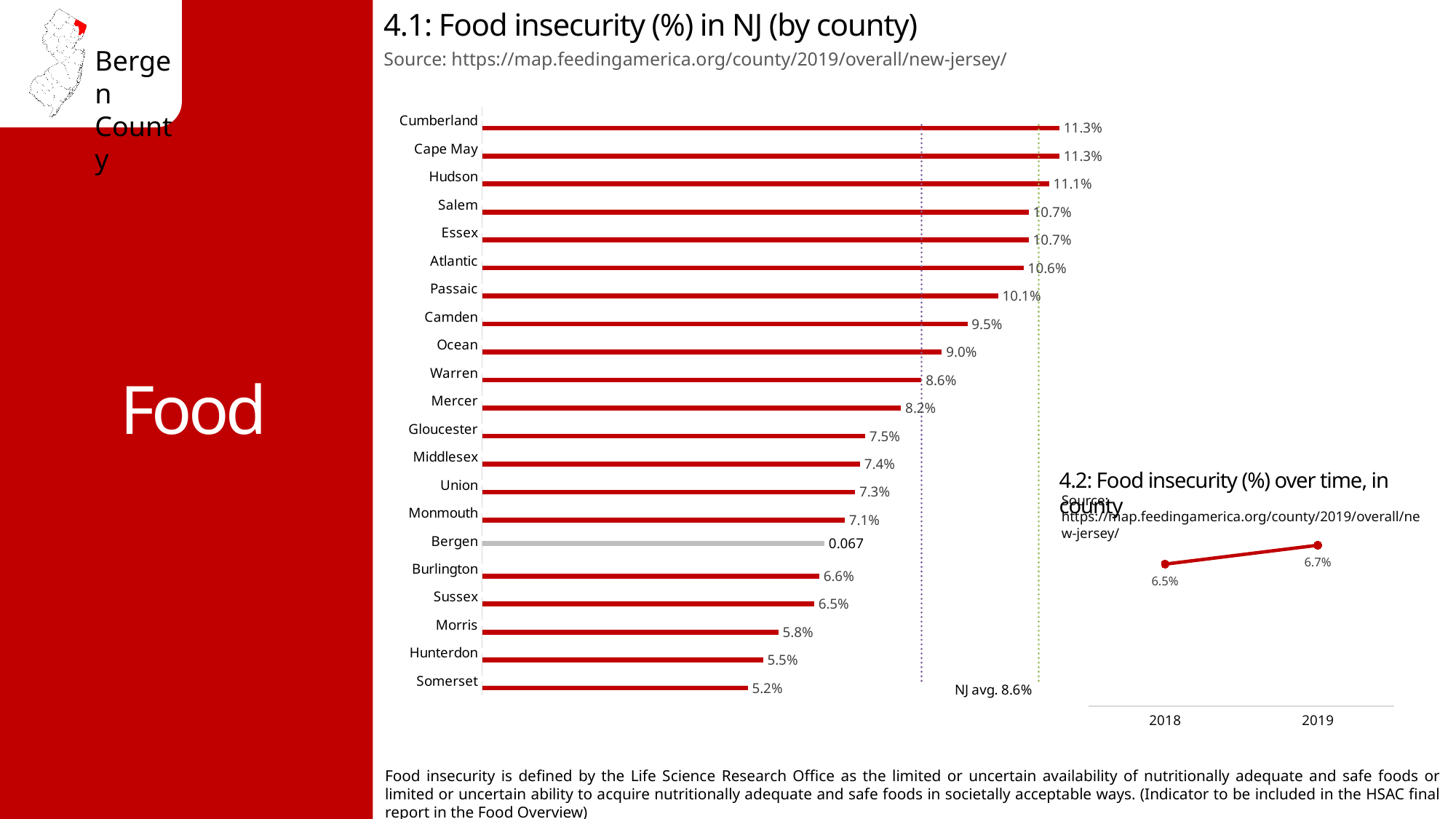
In chart 4.2 (Food insecurity (%) over time, in county), what is the value for 2019? 6.7% In chart 4.2 (Food insecurity (%) over time, in county), what is the difference between the 2019 and 2018 values? 0.2 percentage points In chart 4.1 (Food insecurity (%) in NJ by county), what is the difference between Hudson and Somerset? 5.9 percentage points In chart 4.1 (Food insecurity (%) in NJ by county), what is the value for Camden? 9.5% In chart 4.1 (Food insecurity (%) in NJ by county), how many counties are plotted? 21 In chart 4.1 (Food insecurity (%) in NJ by county), what NJ average value is marked by the dotted line? 8.6% In chart 4.1 (Food insecurity (%) in NJ by county), which is larger, the value for Passaic or the value for Camden? Passaic In chart 4.2 (Food insecurity (%) over time, in county), does the value rise or fall from 2018 to 2019? Rise In chart 4.1 (Food insecurity (%) in NJ by county), what is the value for Hudson? 11.1% In chart 4.1 (Food insecurity (%) in NJ by county), which county has the lowest value? Somerset In chart 4.1 (Food insecurity (%) in NJ by county), what is the value for Morris? 5.8% What kind of chart is chart 4.1 (Food insecurity (%) in NJ by county)? Bar chart